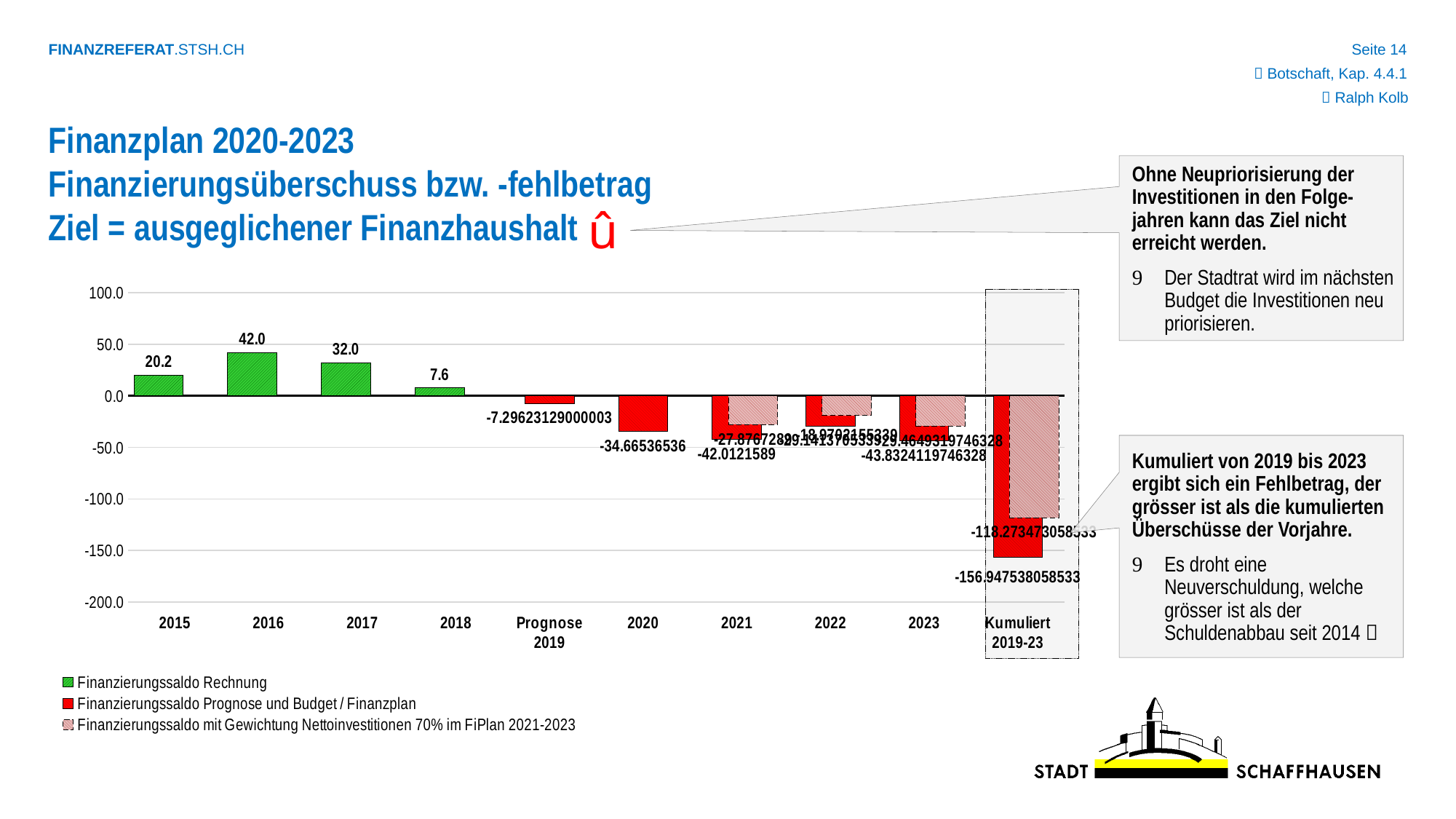
What kind of chart is shown on the slide? bar chart What is the value for 2016? 42.0 Which is larger, the value for 2015 or the value for 2018? 2015 What is the value for 2015? 20.2 What is the value of the Finanzierungssaldo Prognose und Budget / Finanzplan bar for Kumuliert 2019-23? -156.947538058533 Which category has the lowest value? Kumuliert 2019-23 What is the value for 2018? 7.6 How many series does the legend list? 3 What is the difference between the values for 2016 and 2017? 10.0 How many categories are shown on the x axis? 10 Which year has the highest value? 2016 What is the value for 2020? -34.66536536